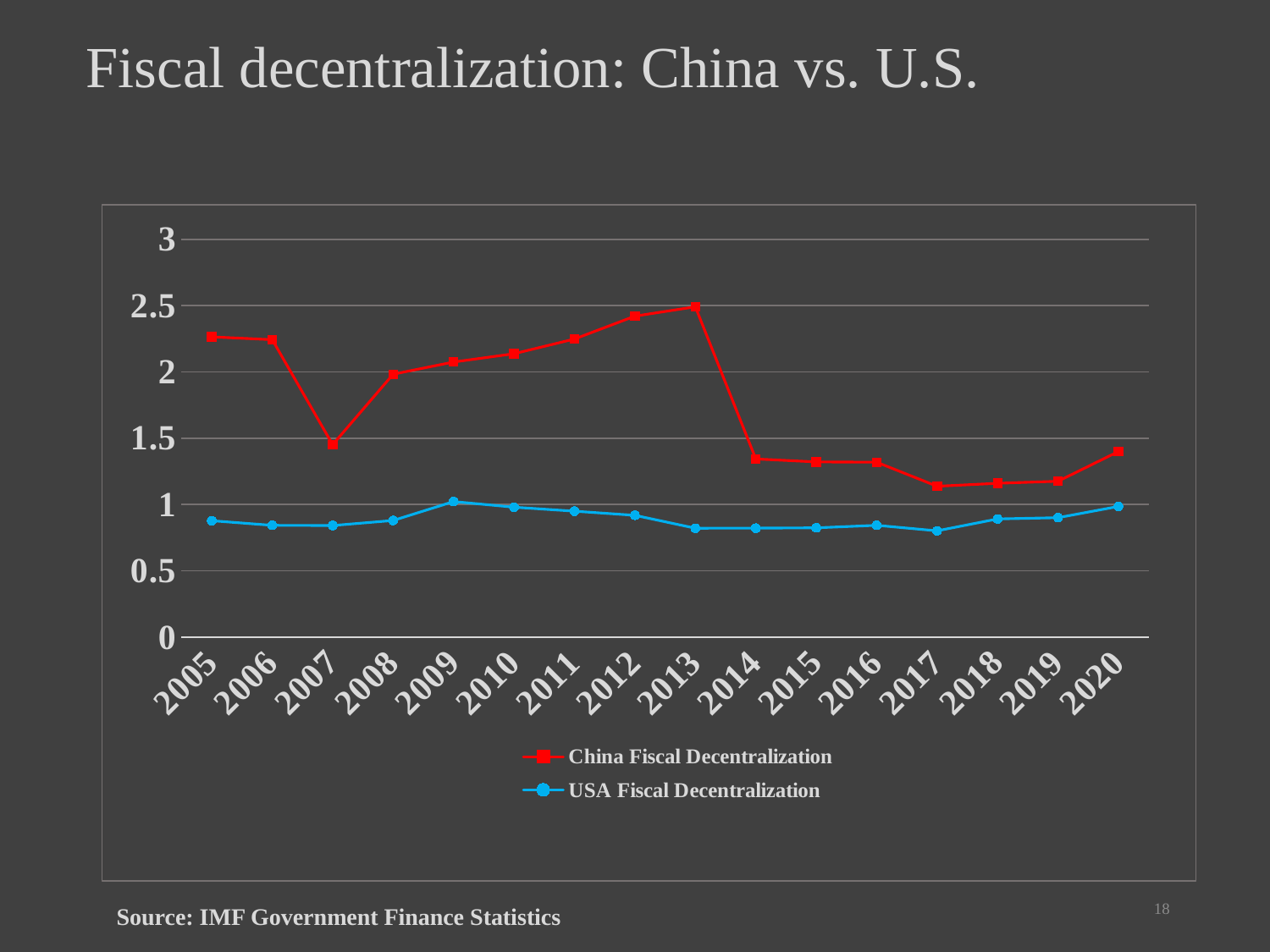
In 2010, which series has the higher value, China Fiscal Decentralization or USA Fiscal Decentralization? China Fiscal Decentralization Does China Fiscal Decentralization rise or fall from 2007 to 2013? rise What kind of chart is shown on the slide? line chart Is the value for China Fiscal Decentralization in 2013 greater or less than 2? greater Is the value for USA Fiscal Decentralization in 2005 greater or less than 1? less How many series does the legend list? 2 Is the value for China Fiscal Decentralization in 2014 greater or less than 1.5? less Which is larger: China Fiscal Decentralization in 2013 or in 2014? 2013 In which year does China Fiscal Decentralization reach its highest value? 2013 What colour is the line for China Fiscal Decentralization? red How many years are plotted along the x axis? 16